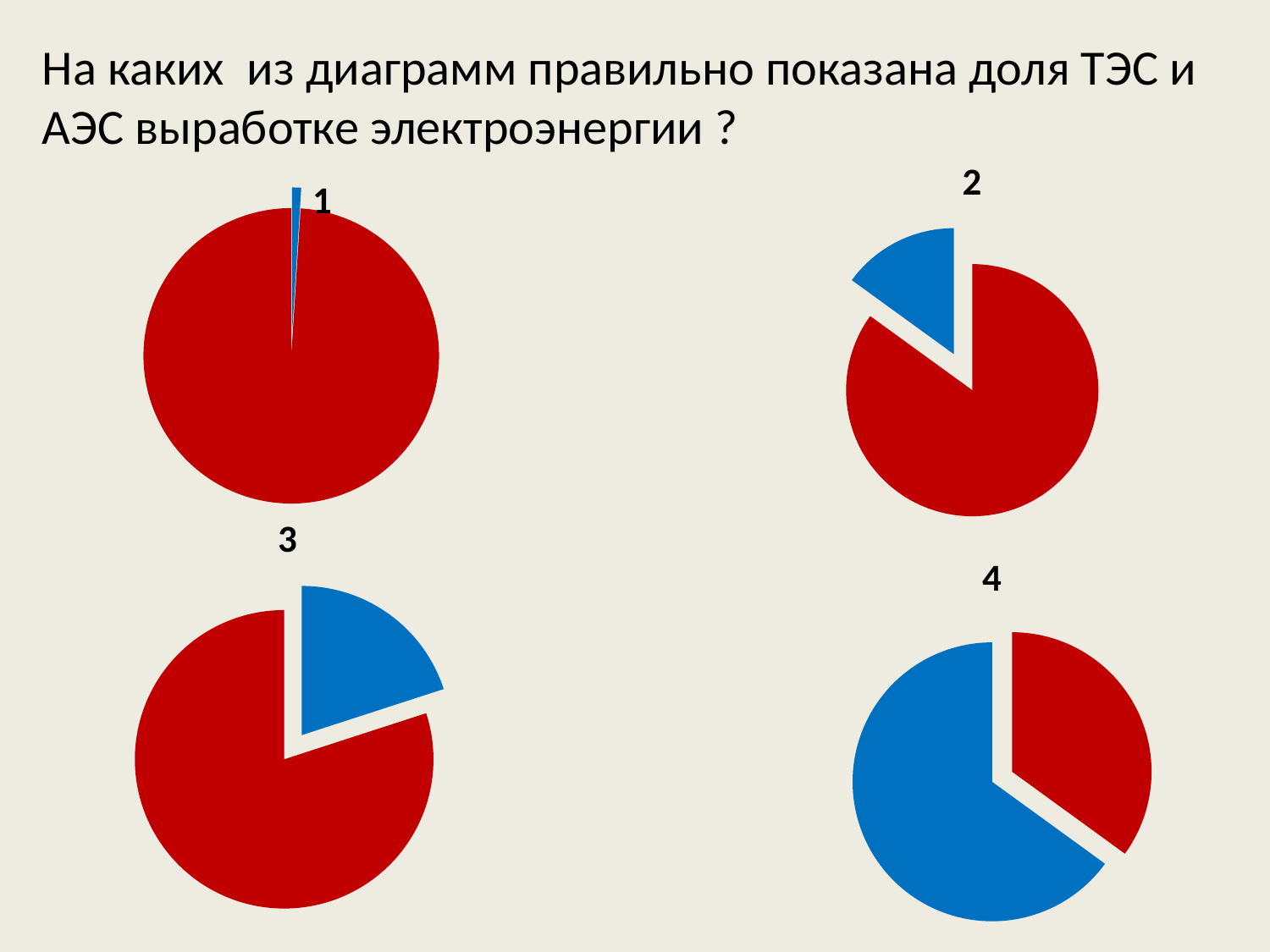
How many pie charts are shown on the slide? 4 How many slices does chart 4 have? 2 What number labels the pie chart in the bottom-right corner of the slide? 4 In chart 2, which slice is larger, the red one or the blue one? red What two colours are used for the slices in the pie charts? red and blue Which of the four charts has the smallest blue slice? chart 1 In chart 1, which slice is larger, the red one or the blue one? red Which of the four charts has the largest blue slice? chart 4 In chart 3, which slice is larger, the red one or the blue one? red How many slices does chart 2 have? 2 What kind of chart is chart 1? pie chart